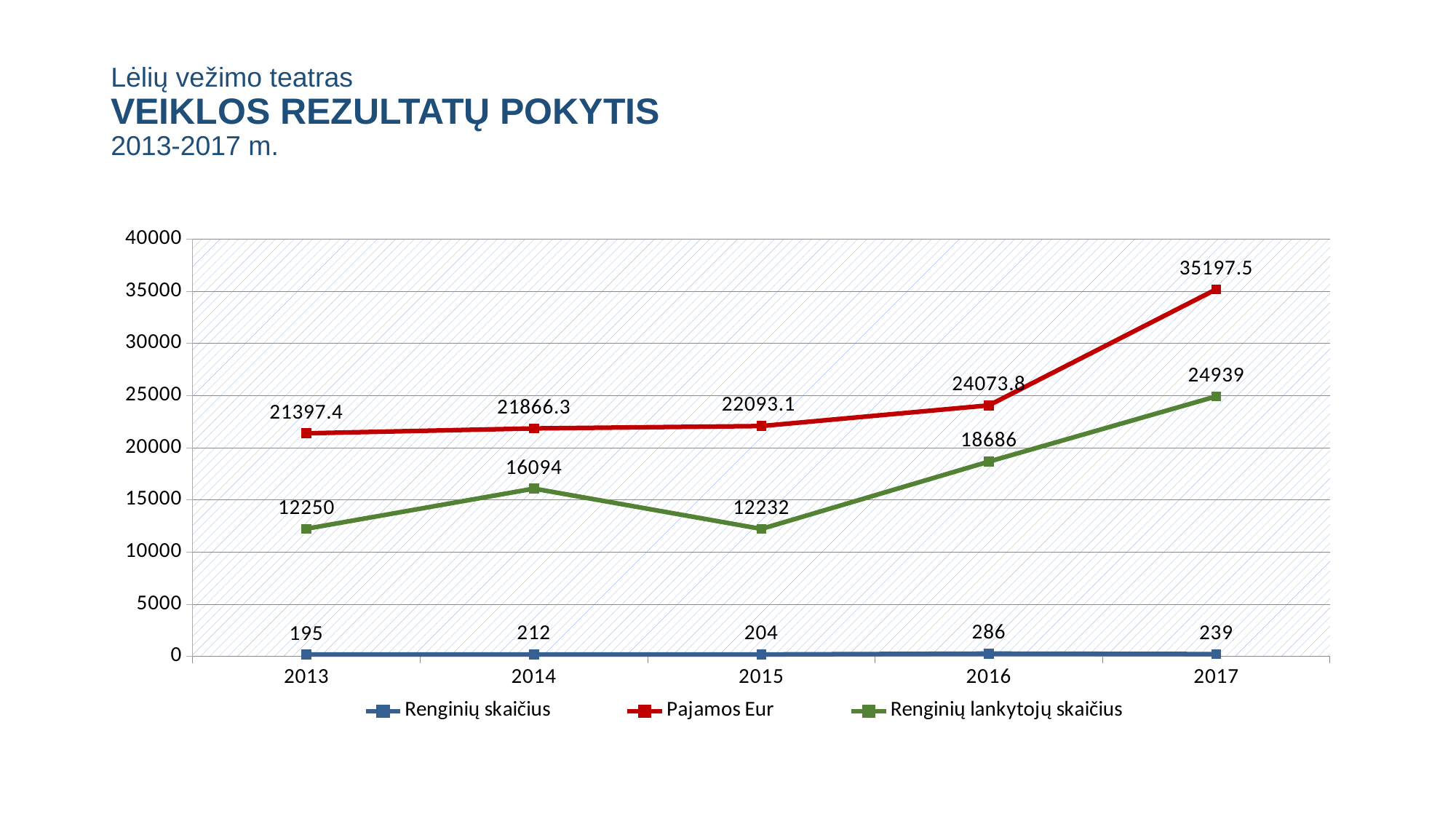
In which year is Renginių lankytojų skaičius lowest? 2015 In which year is Renginių skaičius highest? 2016 What is the value of Renginių skaičius in 2016? 286 Does Pajamos Eur rise or fall from 2013 to 2017? rise What type of chart is shown on the slide? line chart What is the value of Renginių lankytojų skaičius in 2014? 16094 Which is larger: Renginių lankytojų skaičius in 2013 or in 2015? 2013 What is the value of Pajamos Eur in 2017? 35197.5 How many series does the legend list? 3 How many years are plotted on the x axis? 5 Which series is drawn in red? Pajamos Eur What is the difference between Pajamos Eur in 2017 and in 2016? 11123.7